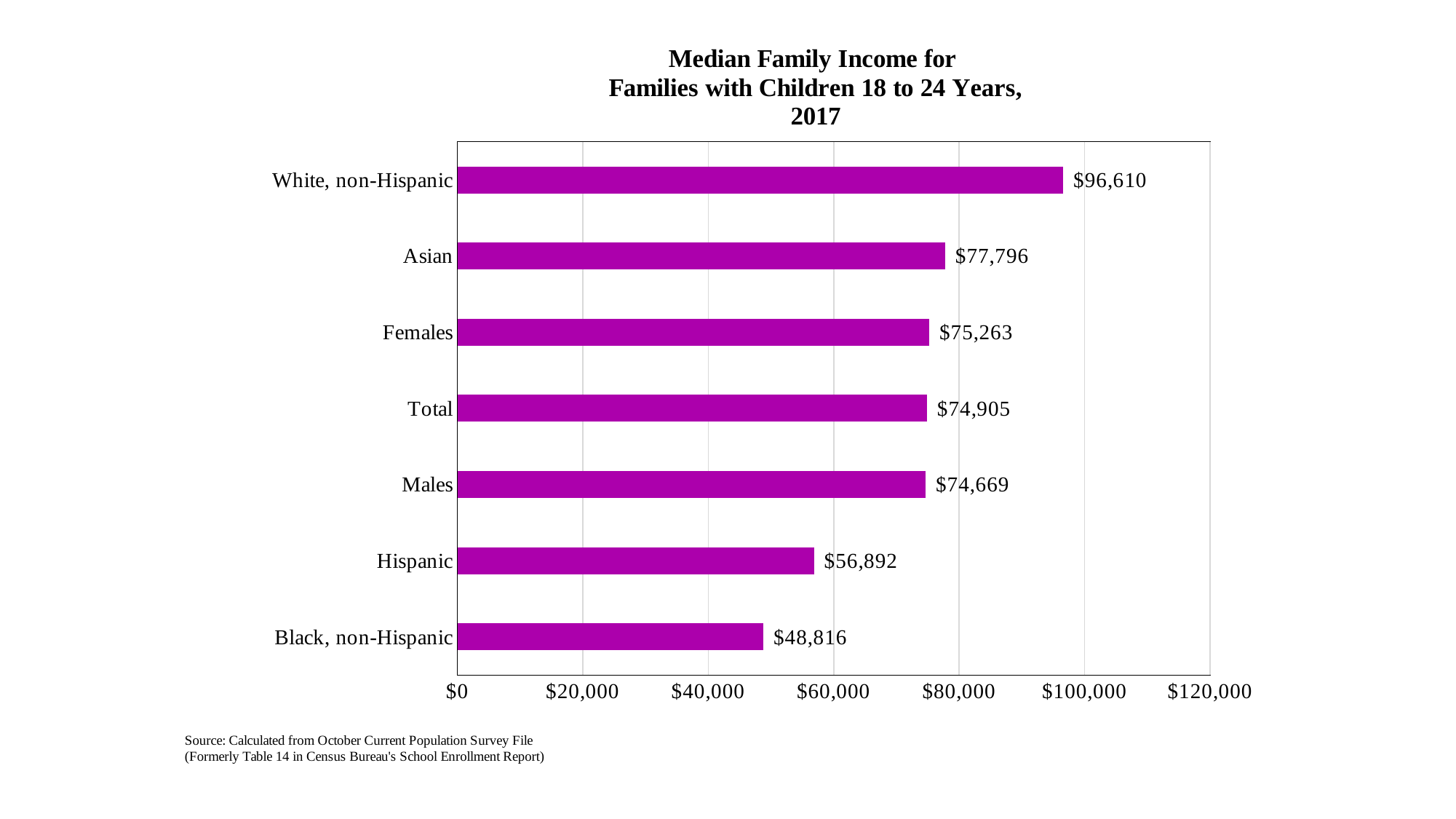
Is the value for Total greater or less than $60,000? greater What is the difference between the median family income for White, non-Hispanic and Black, non-Hispanic families? $47,794 What kind of chart is shown on the slide? Bar chart Which category has the highest median family income? White, non-Hispanic What is the difference between the median family income for Females and Males? $594 What is the median family income for Asian families? $77,796 What is the median family income for Hispanic families? $56,892 What is the median family income for White, non-Hispanic families? $96,610 Which category has the lowest median family income? Black, non-Hispanic What year does the chart title refer to? 2017 Which is larger, the median family income for Asian families or for Hispanic families? Asian How many categories are shown in the chart? 7